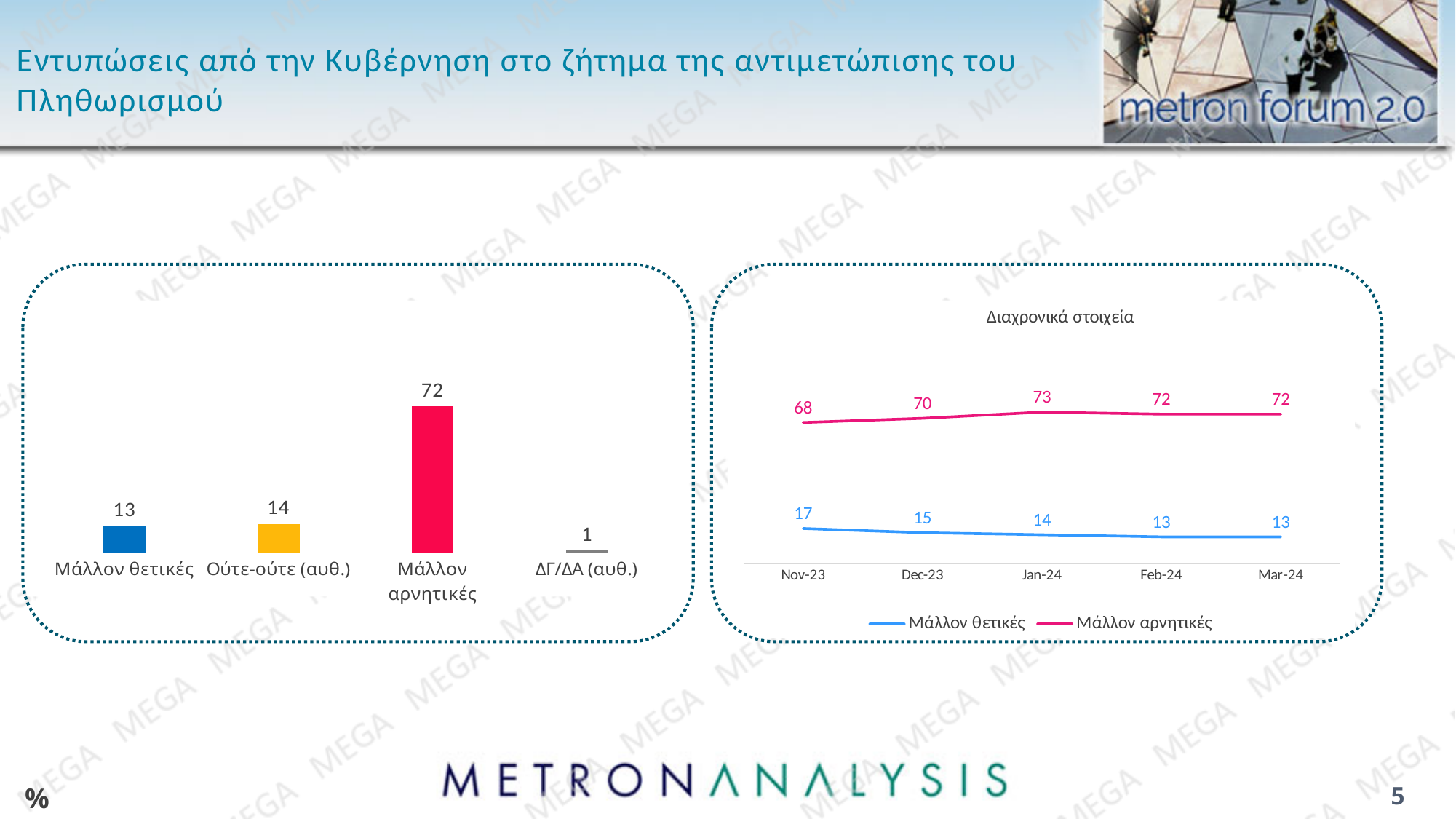
In the Διαχρονικά στοιχεία chart, what is the value for Μάλλον θετικές in Nov-23? 17 In the bar chart on the left, what is the value for Μάλλον αρνητικές? 72 In the Διαχρονικά στοιχεία chart, how many series does the legend list? 2 What kind of chart is the chart on the left? bar chart In the bar chart on the left, what is the value for Μάλλον θετικές? 13 In the bar chart on the left, how many categories are shown? 4 In the Διαχρονικά στοιχεία chart, does the Μάλλον θετικές series rise or fall from Nov-23 to Mar-24? fall In the Διαχρονικά στοιχεία chart, what is the difference between Μάλλον αρνητικές and Μάλλον θετικές in Mar-24? 59 In the bar chart on the left, what is the difference between Μάλλον αρνητικές and Ούτε-ούτε (αυθ.)? 58 In the Διαχρονικά στοιχεία chart, what is the value for Μάλλον αρνητικές in Jan-24? 73 In the bar chart on the left, which category has the lowest value? ΔΓ/ΔΑ (αυθ.) In the bar chart on the left, which category has the highest value? Μάλλον αρνητικές